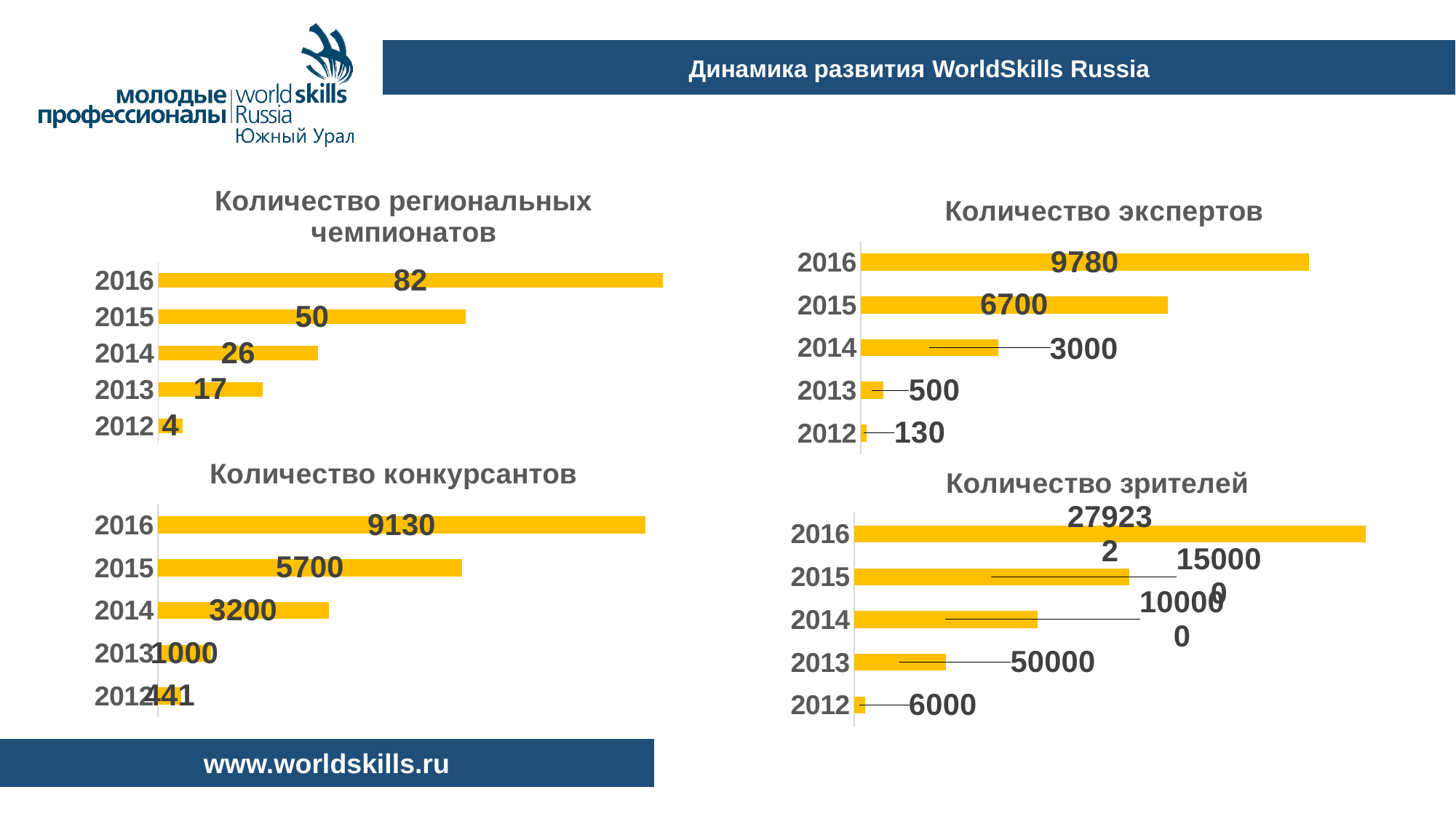
In the chart 'Количество конкурсантов', what is the value for 2014? 3200 In the chart 'Количество экспертов', what is the value for 2012? 130 In the chart 'Количество региональных чемпионатов', what is the value for 2013? 17 In the chart 'Количество экспертов', what is the value for 2015? 6700 In the chart 'Количество региональных чемпионатов', which year has the lowest value? 2012 In the chart 'Количество зрителей', which is larger, the value for 2013 or the value for 2012? 2013 In the chart 'Количество зрителей', what is the value for 2013? 50000 In the chart 'Количество экспертов', which year has the highest value? 2016 In the chart 'Количество региональных чемпионатов', what is the value for 2016? 82 In the chart 'Количество конкурсантов', what is the difference between the values for 2016 and 2015? 3430 How many charts are shown on the slide? 4 In the chart 'Количество региональных чемпионатов', what is the difference between the values for 2015 and 2014? 24